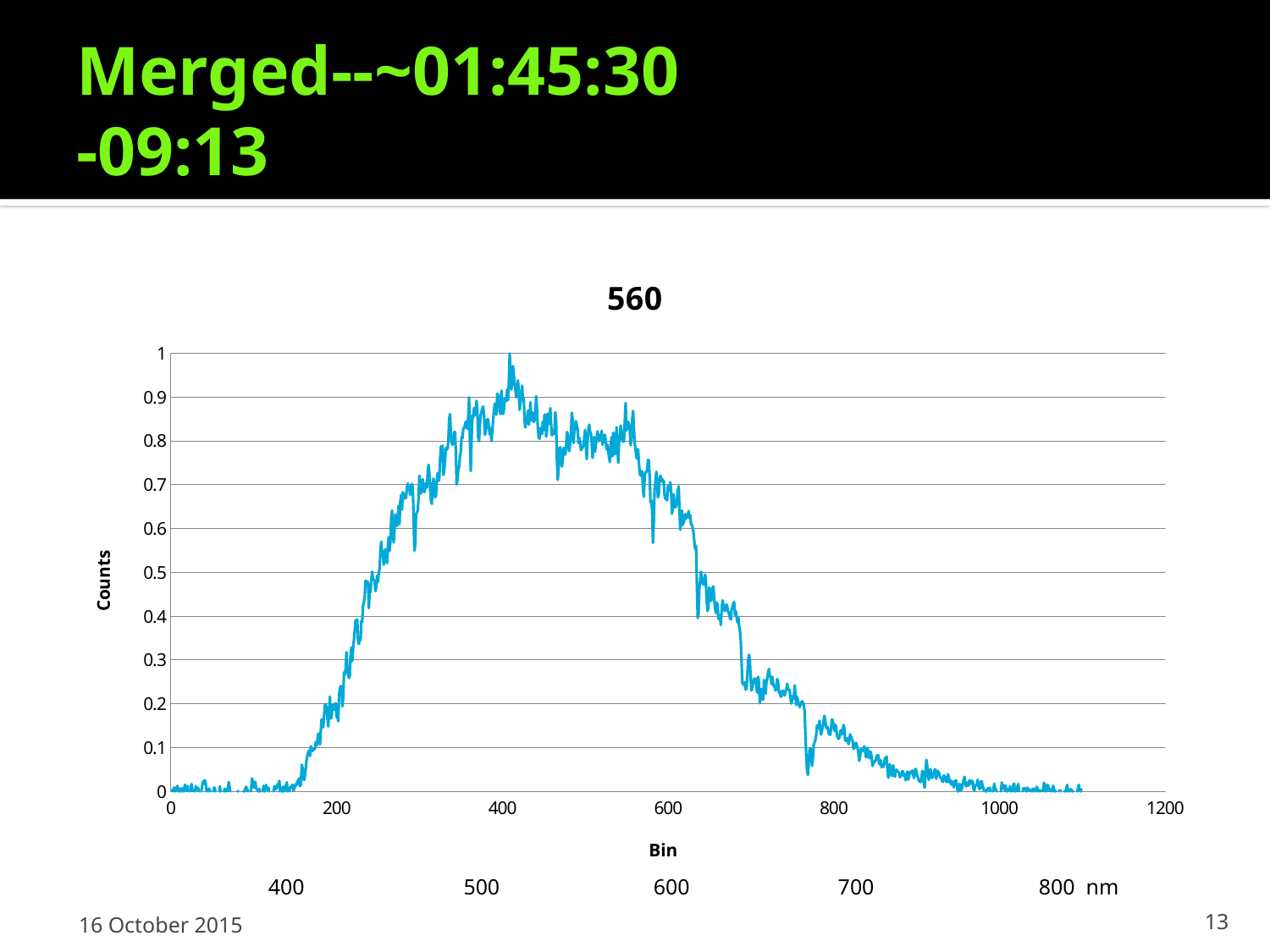
Is the value at bin 800 greater or less than 0.5? less Is the value at bin 1000 greater or less than 0.1? less What is the title of the chart? 560 Is the value at bin 200 greater or less than 0.5? less What kind of chart is shown on the slide? line chart What is the label of the y axis? Counts How many data series are plotted on the chart? 1 Do the values rise or fall along the x axis between bin 600 and bin 1000? fall Do the values rise or fall along the x axis between bin 200 and bin 400? rise Is the value at bin 400 larger or smaller than the value at bin 800? larger